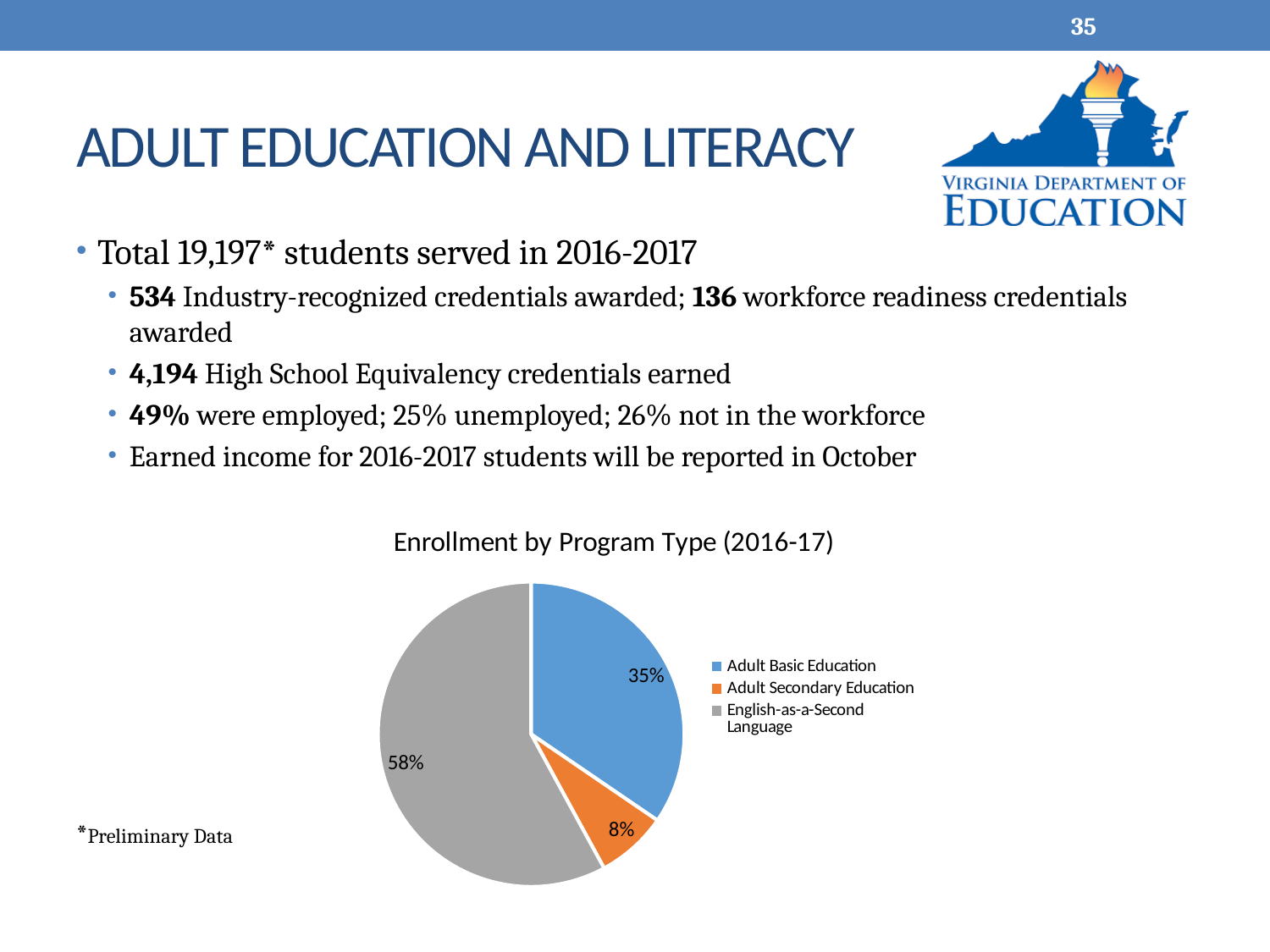
What is the difference in percentage points between the English-as-a-Second Language share and the Adult Basic Education share? 23 How many program types are shown in the pie chart? 3 What colour represents English-as-a-Second Language in the pie chart? gray What share of enrollment is Adult Secondary Education? 8% What share of enrollment is Adult Basic Education? 35% What share of enrollment is English-as-a-Second Language? 58% Which program type has the largest share of enrollment? English-as-a-Second Language What is the title of the chart? Enrollment by Program Type (2016-17) How many entries does the legend list? 3 Which has a larger share of enrollment, Adult Basic Education or Adult Secondary Education? Adult Basic Education What type of chart is shown on the slide? pie chart Which program type has the smallest share of enrollment? Adult Secondary Education